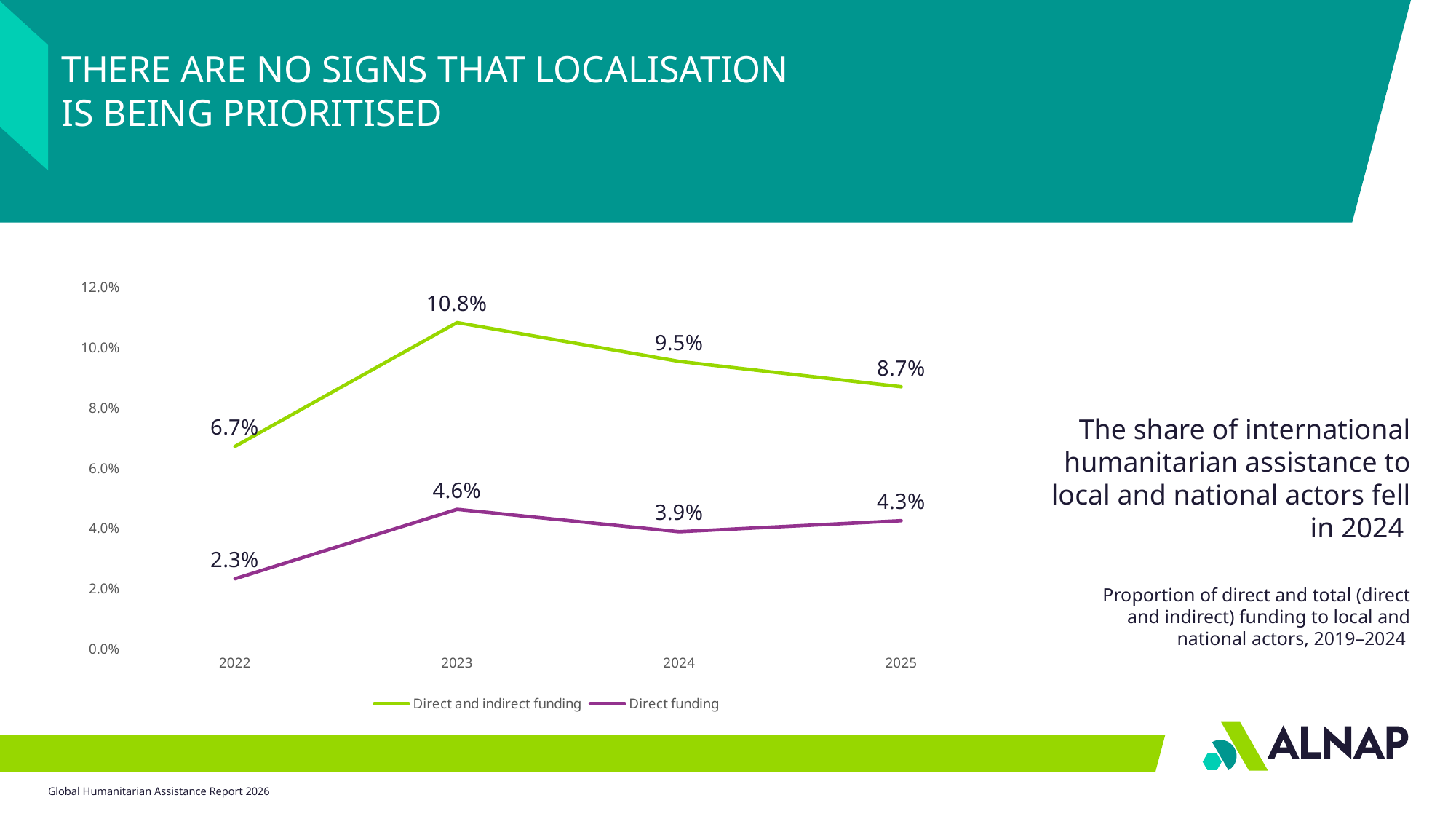
What is the difference between Direct and indirect funding and Direct funding in 2024? 5.6% In which year is Direct and indirect funding highest? 2023 In which year is Direct funding lowest? 2022 Does Direct and indirect funding rise or fall from 2023 to 2025? fall Is the value for Direct and indirect funding in 2025 greater or less than 8.0%? greater Which is larger: Direct funding in 2023 or Direct funding in 2025? Direct funding in 2023 How many series does the legend list? 2 What is the value for Direct and indirect funding in 2023? 10.8% What kind of chart is shown on the slide? line chart What is the value for Direct funding in 2025? 4.3% How many years are shown on the x axis? 4 What is the value for Direct funding in 2022? 2.3%